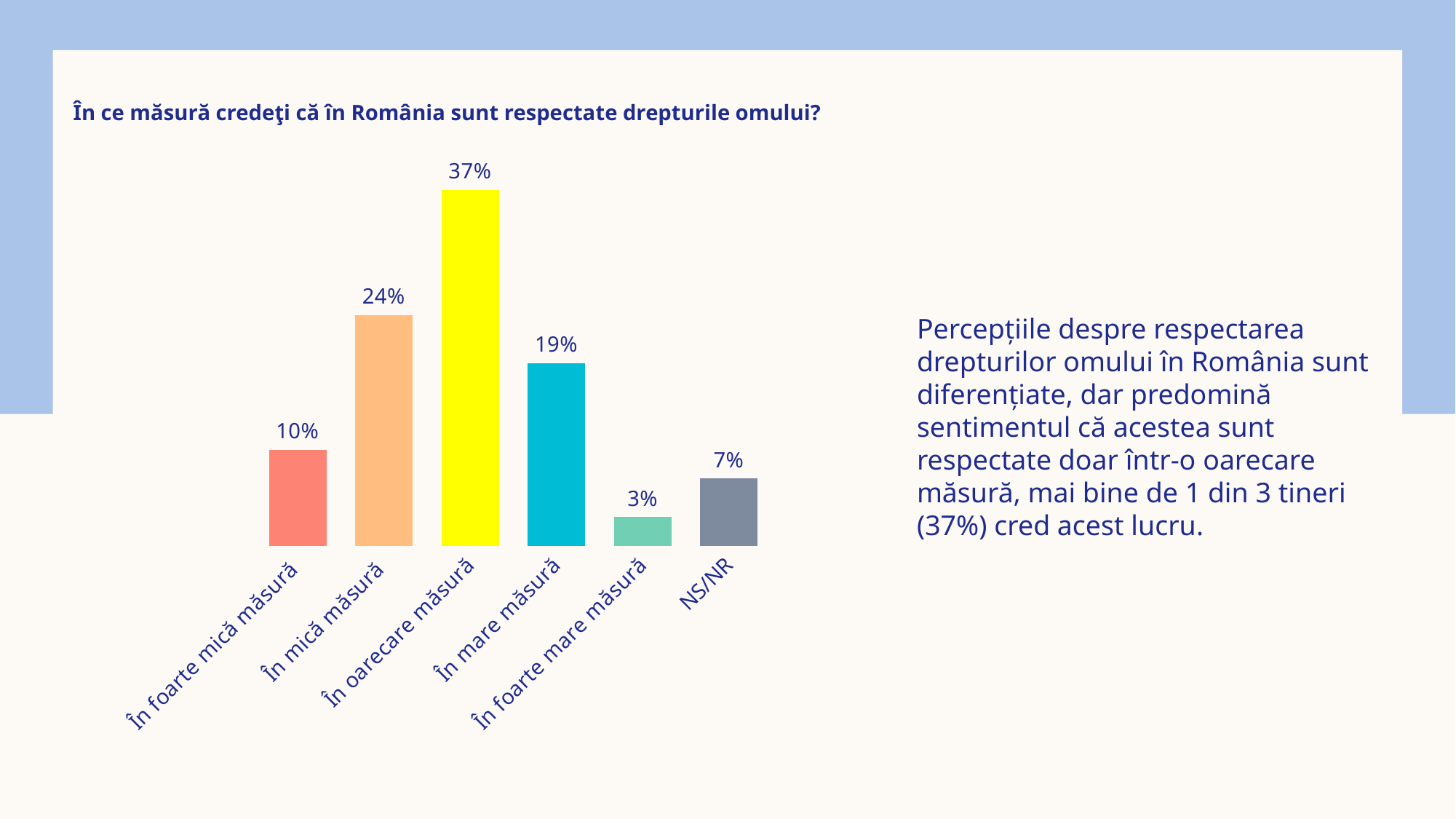
What is the value for "NS/NR"? 7% What is the value for "În foarte mică măsură"? 10% What is the difference between the values for "În oarecare măsură" and "În foarte mică măsură"? 27% What is the difference between the values for "În mică măsură" and "În mare măsură"? 5% What is the value for "În oarecare măsură"? 37% Which category has the lowest value? În foarte mare măsură What colour is the bar for "În oarecare măsură"? Yellow Which category has the highest value? În oarecare măsură Which is larger, the value for "În mică măsură" or the value for "NS/NR"? În mică măsură How many categories are shown in the chart? 6 What kind of chart is shown on the slide? Bar chart What is the value for "În mare măsură"? 19%